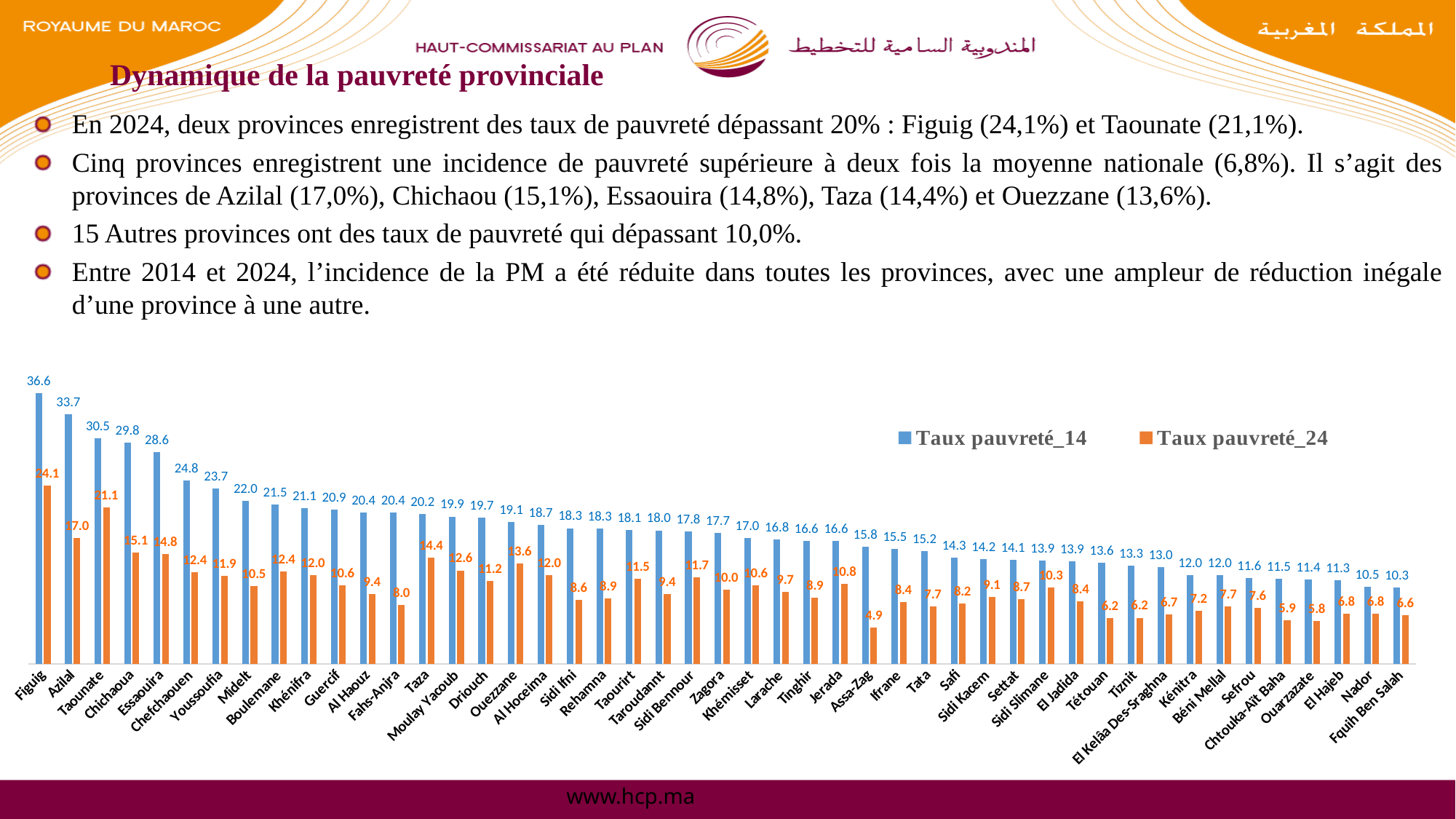
What is the Taux pauvreté_14 value for Taza? 20.2 Which province has the lowest Taux pauvreté_24 value? Assa-Zag What kind of chart is shown on the slide? Bar chart Which province has the highest Taux pauvreté_14 value? Figuig How many series does the legend list? 2 Which province has the lowest Taux pauvreté_14 value? Fquih Ben Salah What is the Taux pauvreté_24 value for Ouezzane? 13.6 Do the Taux pauvreté_14 values rise or fall from left to right along the x axis? Fall What is the difference between the Taux pauvreté_14 and Taux pauvreté_24 values for Figuig? 12.5 Which has the larger Taux pauvreté_24 value, Taounate or Azilal? Taounate What is the difference between the Taux pauvreté_14 and Taux pauvreté_24 values for Azilal? 16.7 What is the Taux pauvreté_24 value for Figuig? 24.1